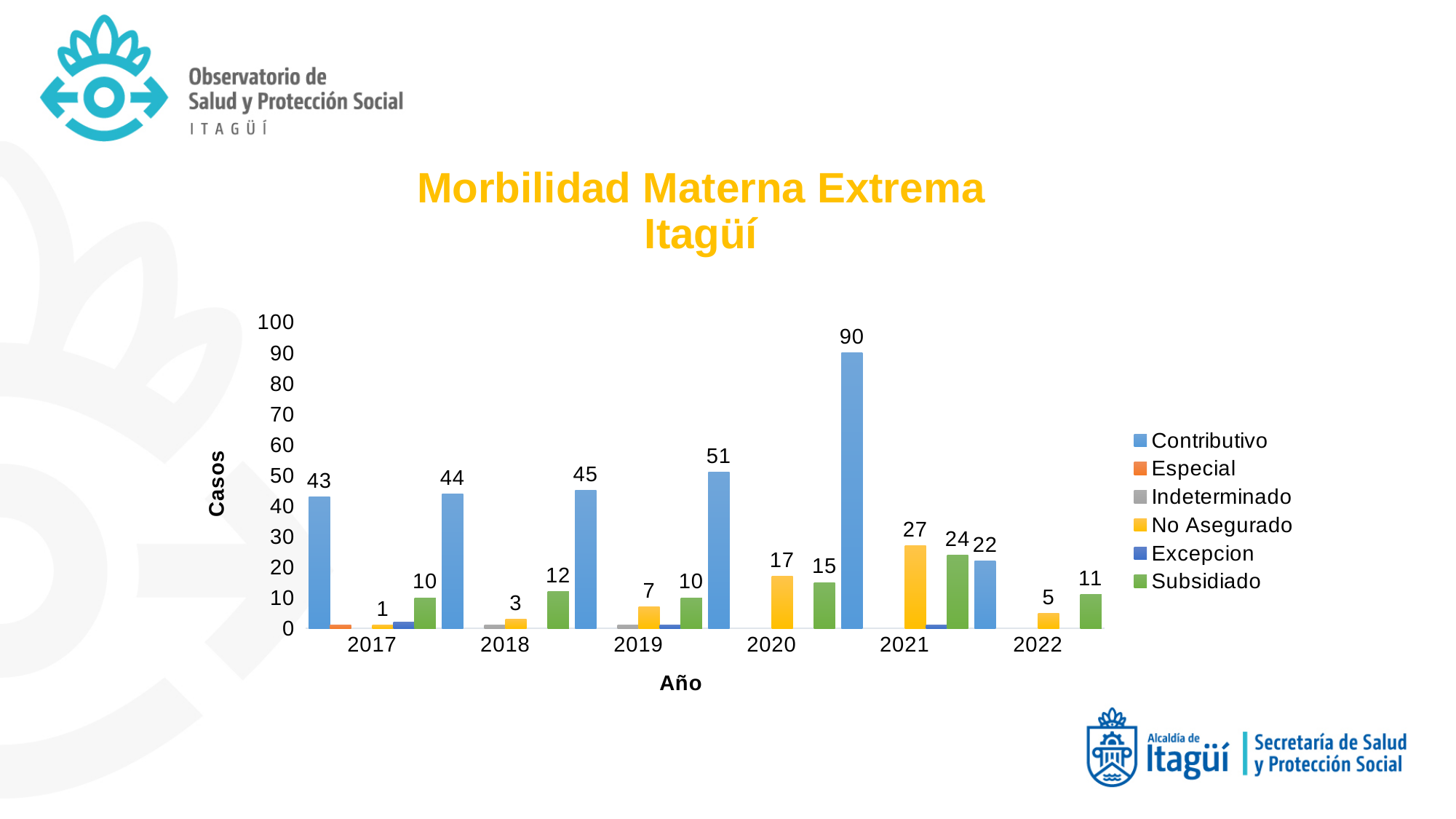
Is the Contributivo value for 2020 greater or less than 60? less How many cases does the Contributivo series show for 2021? 90 What is the difference between the Contributivo values for 2021 and 2020? 39 How many series does the legend list? 6 In which year is the Contributivo value lowest? 2022 In which year is the Contributivo value highest? 2021 What is the value of the Subsidiado series in 2018? 12 What is the value of the No Asegurado series in 2020? 17 What is the title of the y axis? Casos What kind of chart is shown on the slide? Bar chart In 2021, which is larger: No Asegurado or Subsidiado? No Asegurado How many years are shown on the x axis? 6